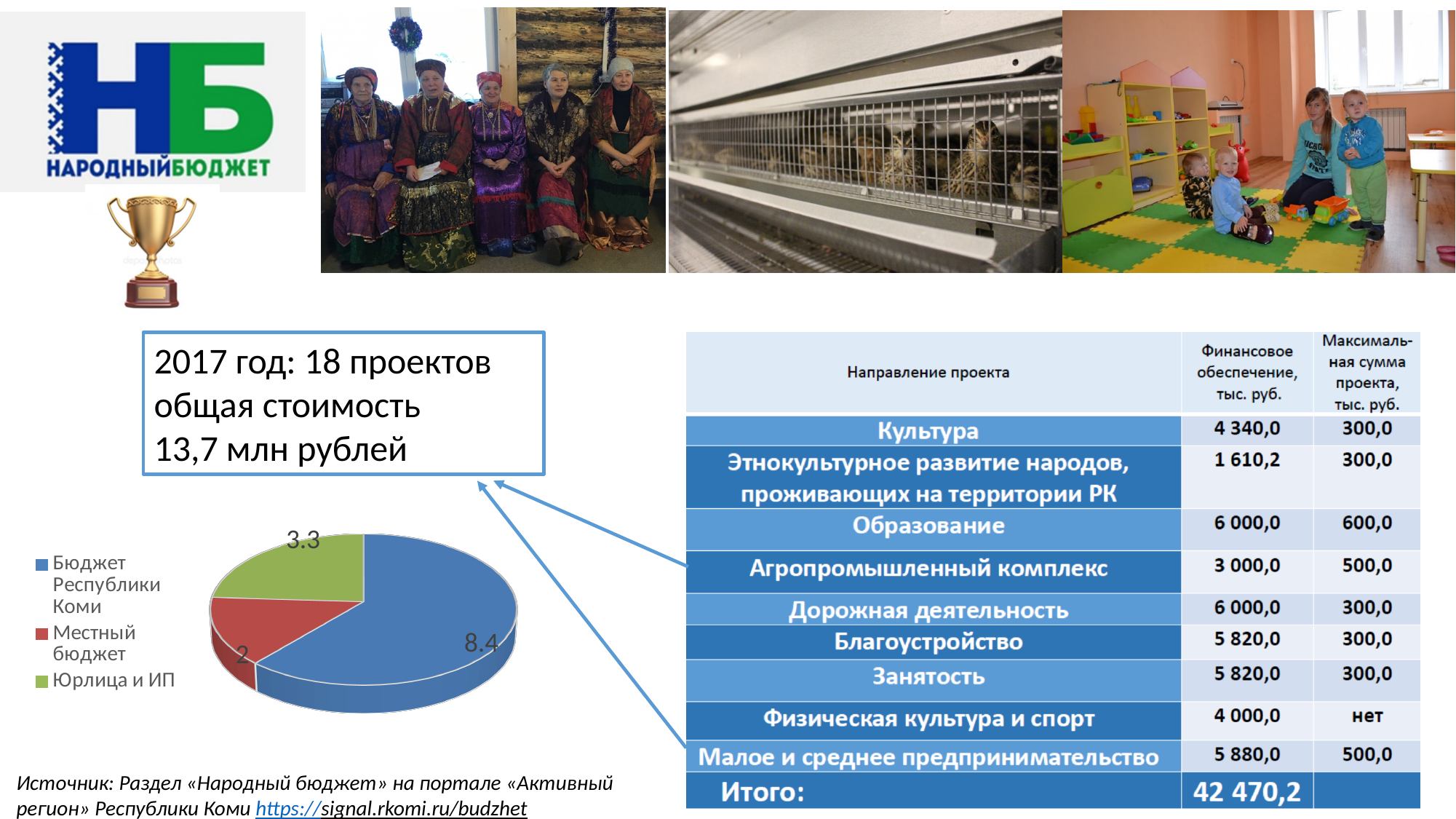
Which category has the smallest slice in the pie chart? Местный бюджет In the pie chart, what is the value for Юрлица и ИП? 3.3 What is the difference between the values for Юрлица и ИП and Местный бюджет in the pie chart? 1.3 In the pie chart, what is the value for Местный бюджет? 2 Which category has the largest slice in the pie chart? Бюджет Республики Коми What is the difference between the values for Бюджет Республики Коми and Юрлица и ИП in the pie chart? 5.1 In the pie chart, what is the value for Бюджет Республики Коми? 8.4 How many slices does the pie chart have? 3 What colour is the slice for Юрлица и ИП in the pie chart? green How many entries does the pie chart legend list? 3 Which is larger in the pie chart: Юрлица и ИП or Местный бюджет? Юрлица и ИП What kind of chart is shown on the slide? pie chart